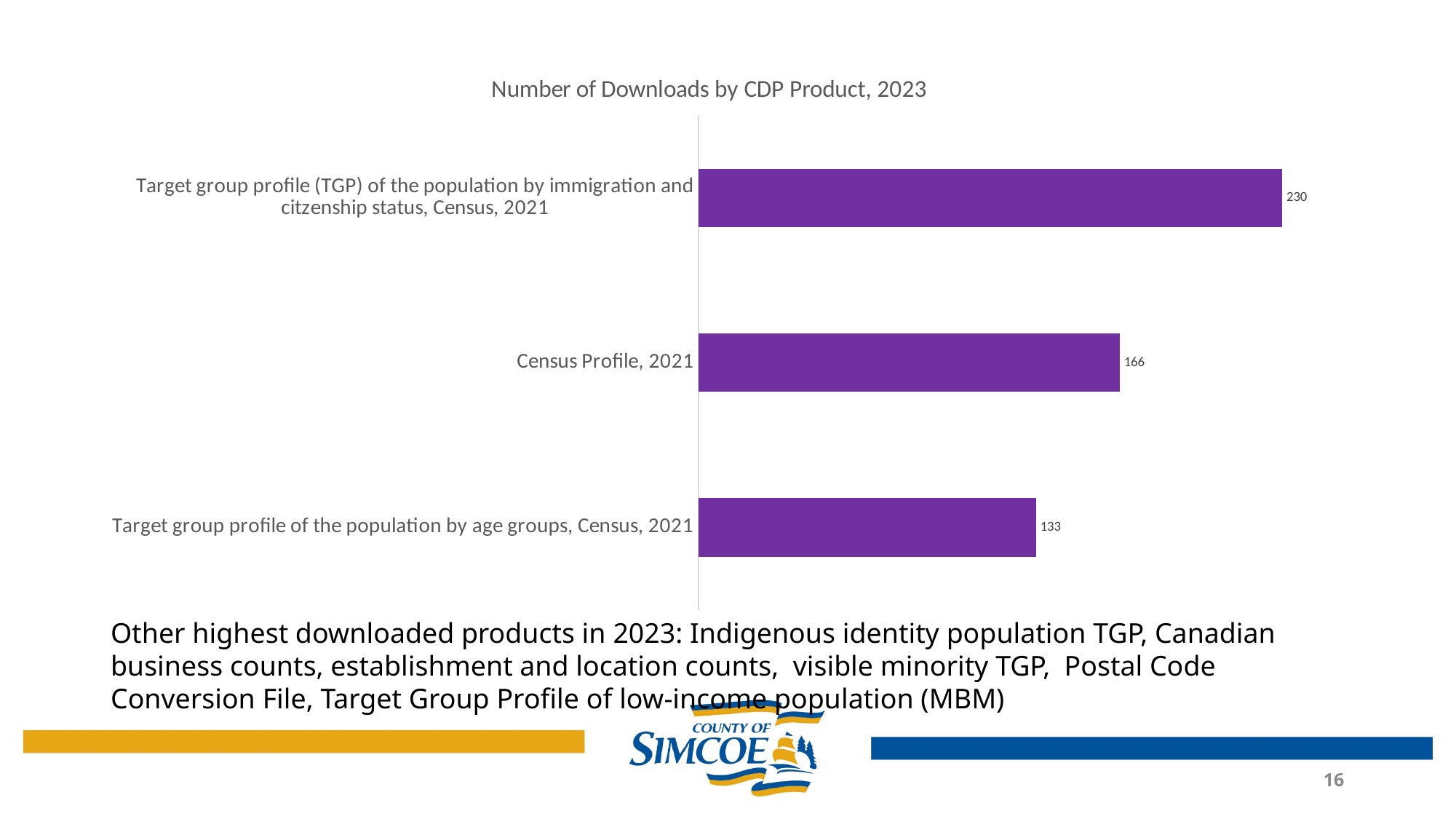
How many CDP products are shown in the chart? 3 What is the value for Target group profile of the population by age groups, Census, 2021? 133 What is the number of downloads for Census Profile, 2021? 166 What is the difference in downloads between the immigration and citizenship status TGP and Census Profile, 2021? 64 What is the difference in downloads between Census Profile, 2021 and the age groups TGP? 33 What colour are the bars in the chart? Purple What kind of chart is shown on the slide? Bar chart Which has more downloads: Census Profile, 2021 or the Target group profile of the population by age groups, Census, 2021? Census Profile, 2021 Which CDP product has the highest number of downloads? Target group profile (TGP) of the population by immigration and citzenship status, Census, 2021 What is the title of the chart? Number of Downloads by CDP Product, 2023 Which CDP product has the lowest number of downloads? Target group profile of the population by age groups, Census, 2021 How many downloads are shown for the Target group profile (TGP) of the population by immigration and citzenship status, Census, 2021? 230